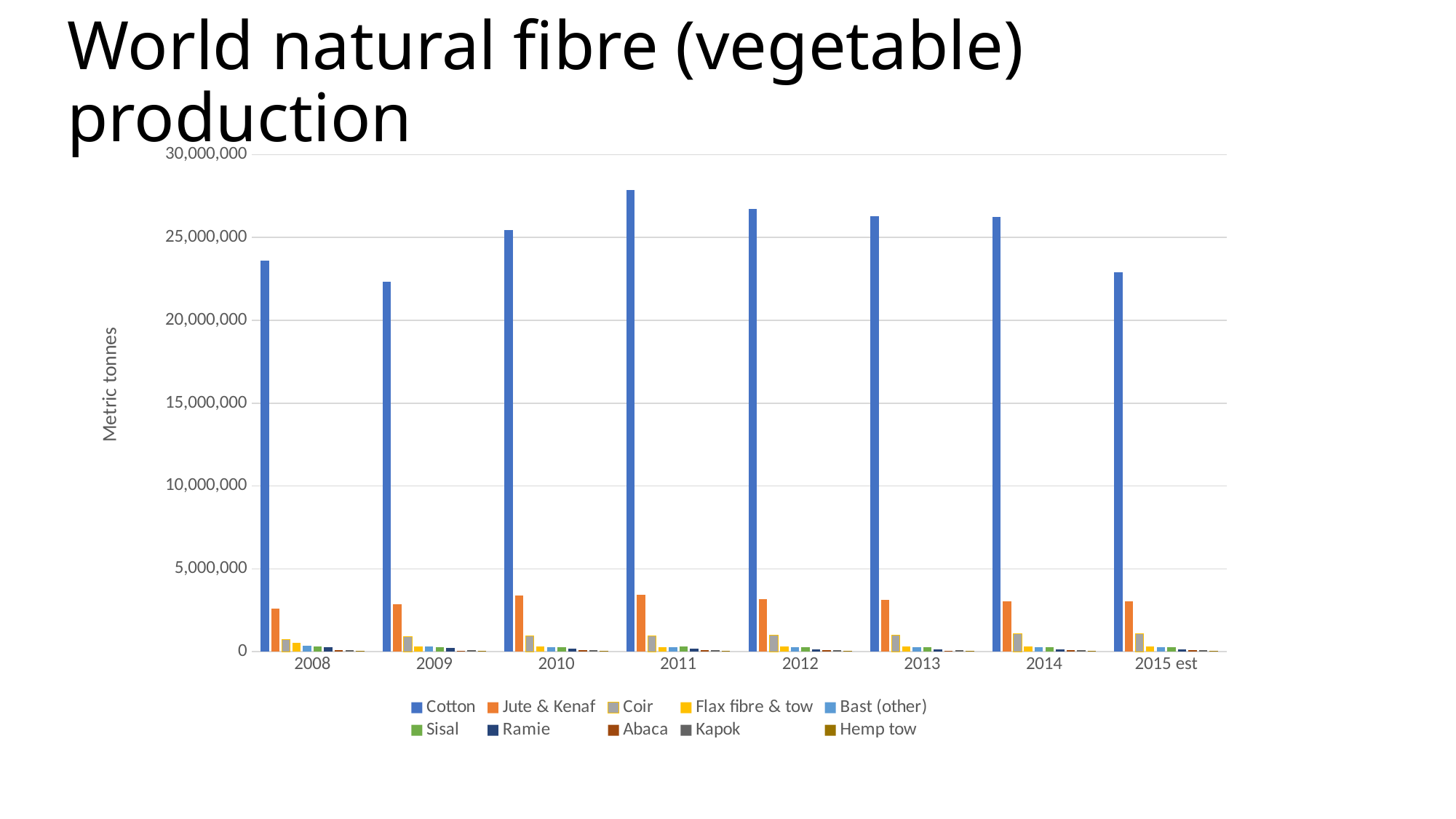
In which year is Cotton production lowest? 2009 In which year is Cotton production highest? 2011 Is the value for Jute & Kenaf in 2011 greater or less than 5,000,000? less Between 2009 and 2011, does Cotton production rise or fall? rise How many series does the legend list? 10 Which series has the largest value in every year shown? Cotton Is the value for Cotton in 2011 greater or less than 25,000,000? greater Is the value for Cotton in 2008 greater or less than 25,000,000? less What kind of chart is shown on the slide? Bar chart How many years (categories) are shown on the x axis? 8 Which is larger, Cotton production in 2010 or in 2009? 2010 What is the label on the vertical axis? Metric tonnes